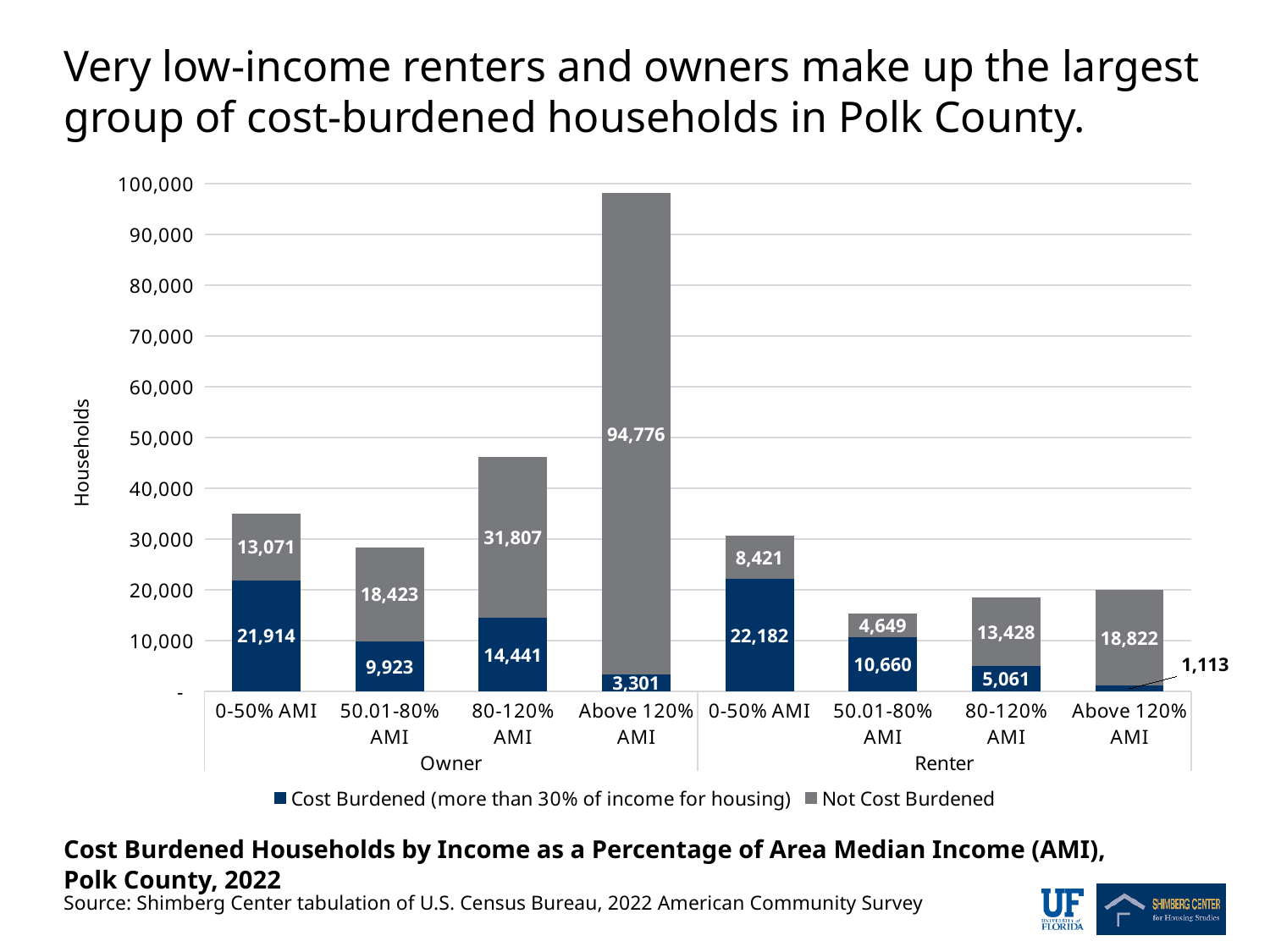
How many series does the legend list? 2 What is the difference between cost-burdened Renter households at 0-50% AMI and cost-burdened Owner households at 0-50% AMI? 268 What is the number of not cost-burdened Renter households in the Above 120% AMI group? 18,822 How many income categories are plotted in total across Owner and Renter? 8 What is the total number of households (cost burdened plus not cost burdened) for Renters at 50.01-80% AMI? 15,309 What type of chart is shown on the slide? Stacked bar chart Which category has the smallest number of cost-burdened households? Renter, Above 120% AMI Which category has the largest number of not cost-burdened households? Owner, Above 120% AMI Which is larger: the number of cost-burdened Owner households at 80-120% AMI or the number of cost-burdened Renter households at 80-120% AMI? Owner, 80-120% AMI What is the number of cost-burdened Renter households in the 50.01-80% AMI group? 10,660 What is the number of cost-burdened Owner households in the 0-50% AMI group? 21,914 Is the total height of the Owner Above 120% AMI bar greater or less than 90,000? greater